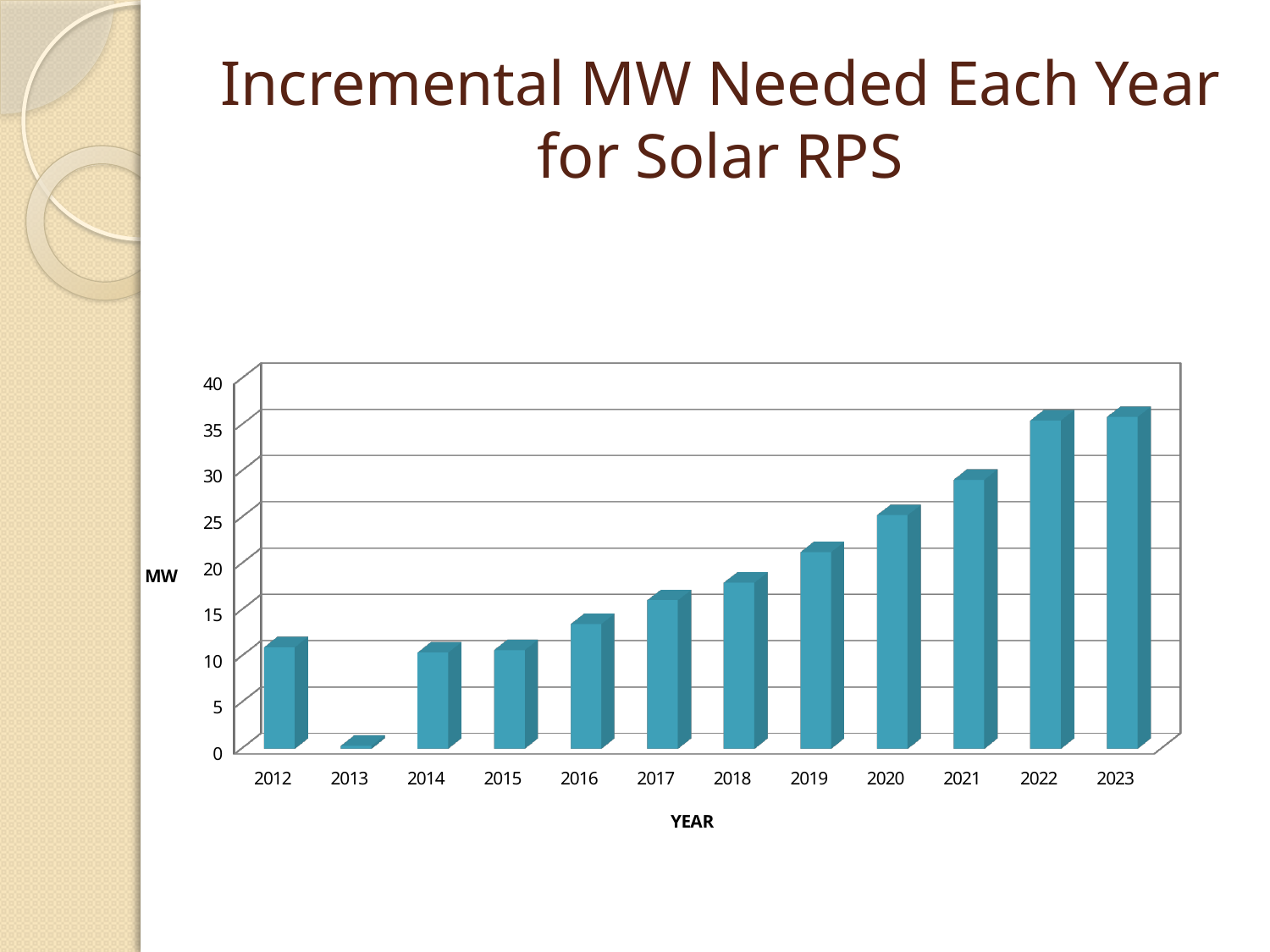
Is the value for 2022 greater or less than 30? greater How many years are shown on the x axis of the chart? 12 What is the label on the horizontal axis of the chart? YEAR Is the value for 2019 greater or less than 25? less What is the label on the vertical axis of the chart? MW Is the value for 2016 greater or less than 10? greater Which year has the lowest incremental MW needed? 2013 Which year has the larger value, 2017 or 2020? 2020 Do the values generally rise or fall from 2013 to 2023? rise What kind of chart is shown on the slide? bar chart